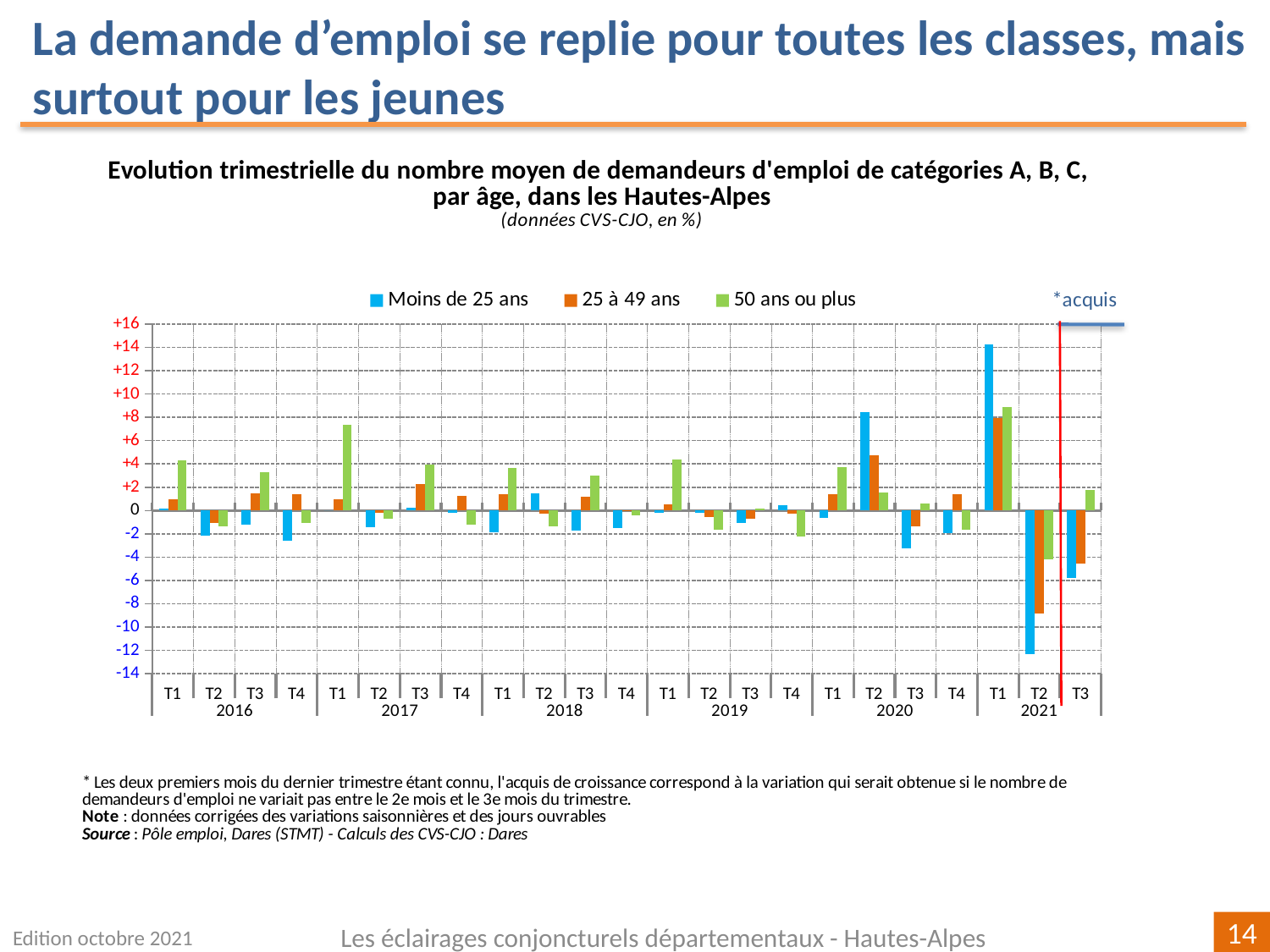
Which quarter is marked by the red vertical line as the 'acquis' (estimated) quarter? T3 2021 What kind of chart is shown on the slide? bar chart In T2 2020, which is larger: the value for Moins de 25 ans or for 25 à 49 ans? Moins de 25 ans Is the value for Moins de 25 ans in T1 2021 greater or less than +12? greater Is the value for Moins de 25 ans in T2 2021 greater or less than -10? less Is the value for 50 ans ou plus in T1 2017 greater or less than +6? greater How many quarters are shown on the x axis? 23 How many series does the legend list? 3 In which quarter is the value for Moins de 25 ans lowest? T2 2021 Which series are listed in the legend? Moins de 25 ans, 25 à 49 ans, 50 ans ou plus In which quarter is the value for Moins de 25 ans highest? T1 2021 In which quarter is the value for 25 à 49 ans lowest? T2 2021